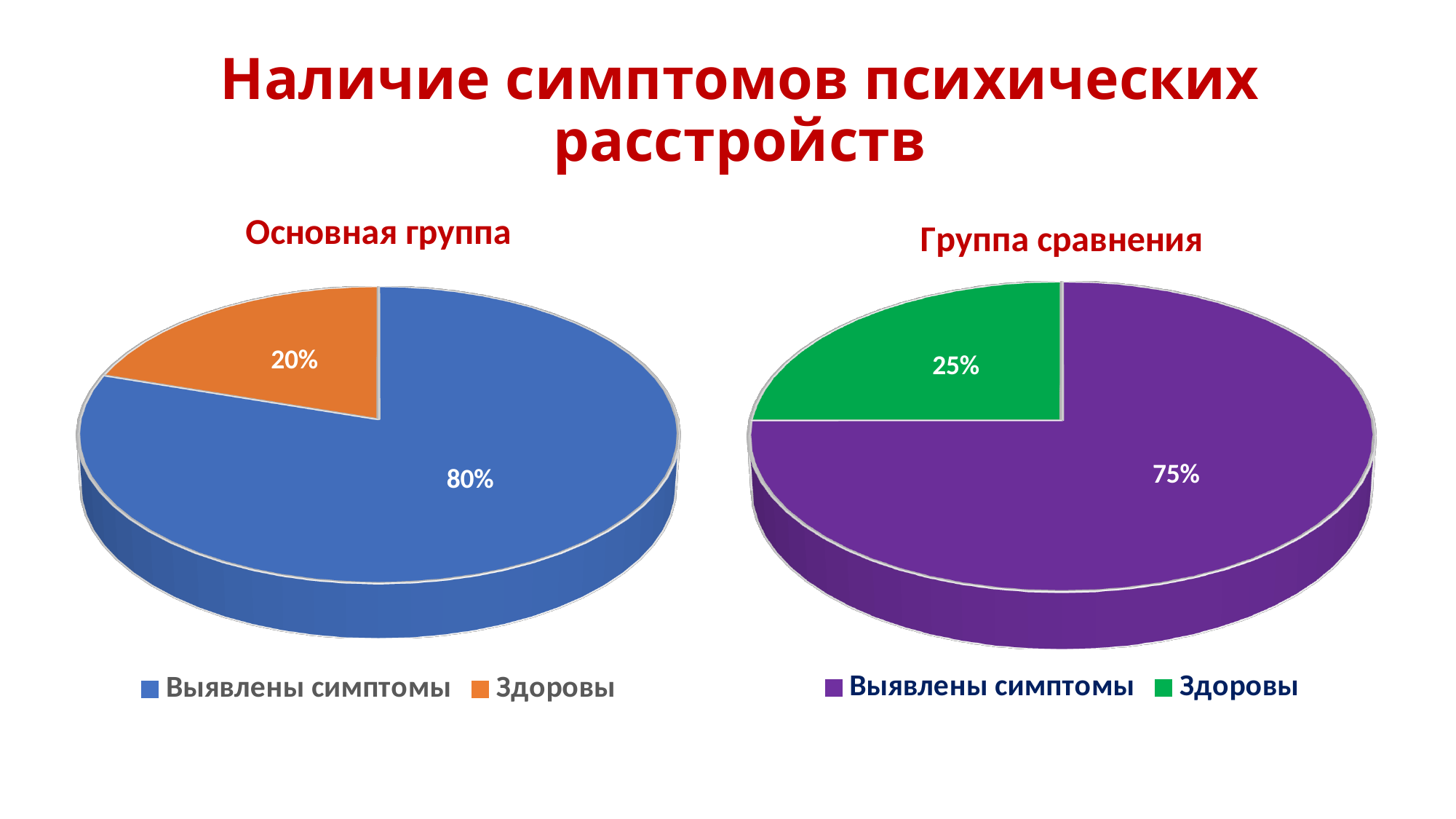
In the "Группа сравнения" chart, what share is labelled for "Выявлены симптомы"? 75% In the "Основная группа" chart, what is the difference between the "Выявлены симптомы" and "Здоровы" shares? 60% In the "Основная группа" chart, what share is labelled for "Выявлены симптомы"? 80% In the "Основная группа" chart, what share is labelled for "Здоровы"? 20% In the "Группа сравнения" chart, what is the difference between the "Выявлены симптомы" and "Здоровы" shares? 50% How many slices does the "Группа сравнения" chart have? 2 In the "Основная группа" chart, which slice is the largest? Выявлены симптомы In the "Группа сравнения" chart, what share is labelled for "Здоровы"? 25% In the "Группа сравнения" chart, what colour is the "Здоровы" slice? Green In the "Группа сравнения" chart, which slice is the smallest? Здоровы Which chart has the larger "Здоровы" share, "Основная группа" or "Группа сравнения"? Группа сравнения What type of chart is the "Основная группа" chart? Pie chart